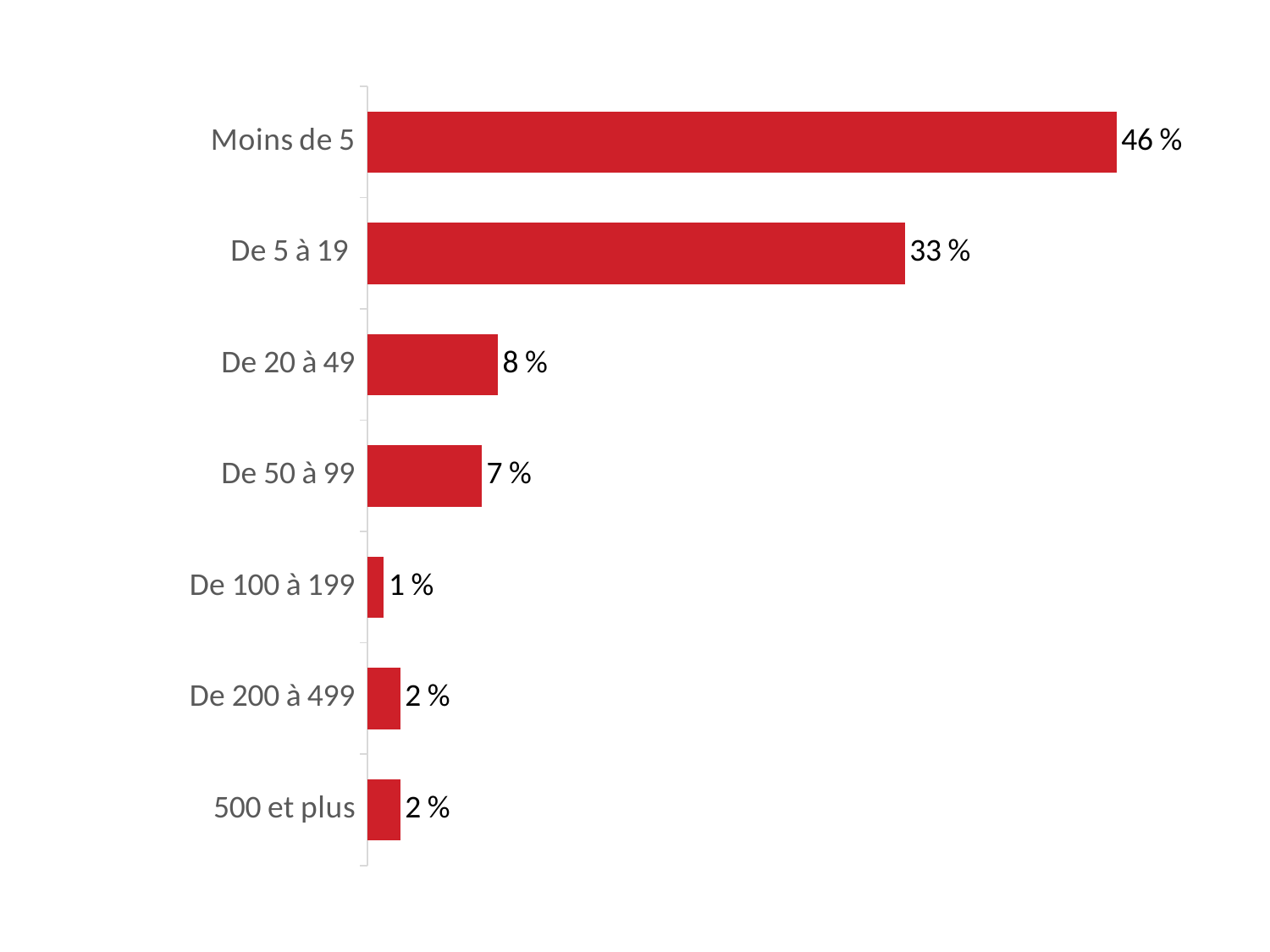
What is the difference between the values for "Moins de 5" and "De 5 à 19"? 13 % What is the value for "De 20 à 49"? 8 % Which category has the lowest value? De 100 à 199 Which is larger, the value for "De 50 à 99" or the value for "De 200 à 499"? De 50 à 99 What kind of chart is this? Bar chart What is the value for "Moins de 5"? 46 % How many categories are shown in the chart? 7 Which category has the highest value? Moins de 5 What is the value for "De 5 à 19"? 33 % What is the value for "De 100 à 199"? 1 % What is the difference between the values for "De 20 à 49" and "De 50 à 99"? 1 % What colour are the bars in the chart? Red